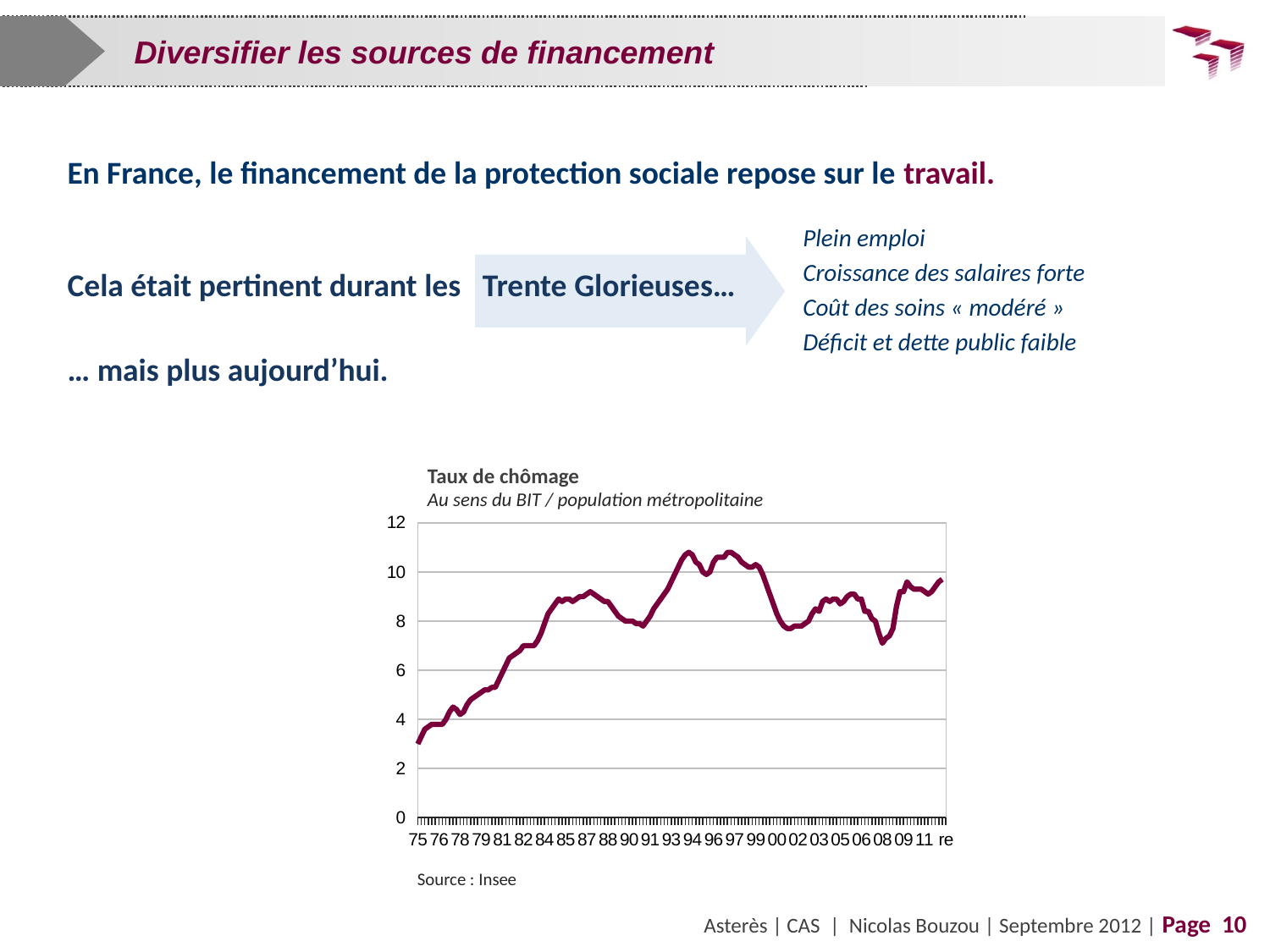
Does the unemployment rate rise or fall between 75 and 85? rise What source is cited below the chart? Insee What is the title of the chart? Taux de chômage Is the unemployment rate in 11 greater or less than 8? greater Is the unemployment rate in 75 greater or less than 4? less What type of chart is shown on the slide? line chart Is the peak unemployment rate around 94 greater or less than 10? greater What is the highest value shown on the y axis? 12 In which year on the x axis is the unemployment rate lowest? 75